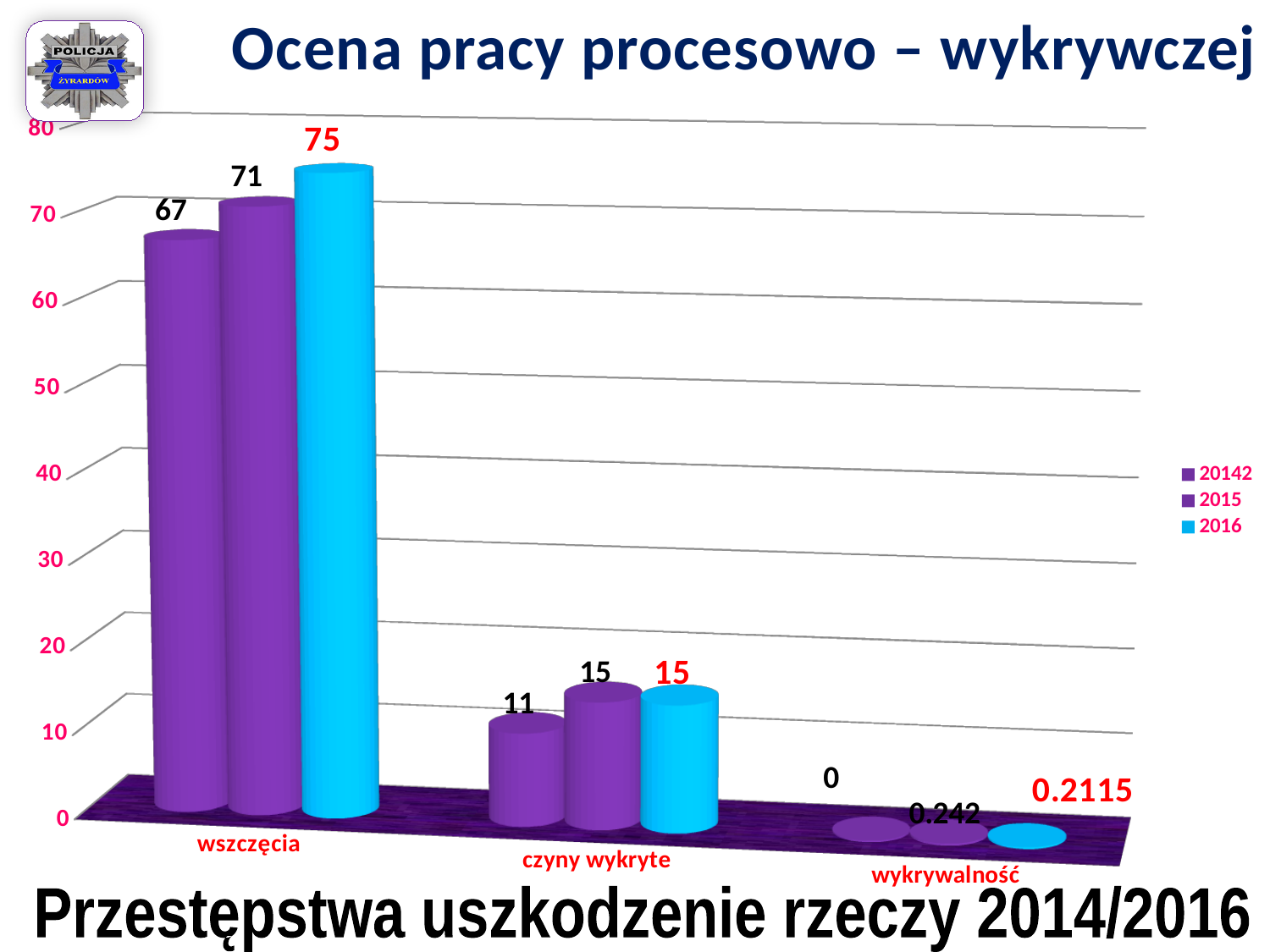
What is the value for czyny wykryte in the 2015 series? 15 What is the difference between the 2016 and 2015 values for wszczęcia? 4 Which category has the lowest value in the 2016 series? wykrywalność What is the value for wszczęcia in the series labelled 20142? 67 What is the value for wszczęcia in the 2016 series? 75 How many categories are shown on the x axis? 3 Which is larger for czyny wykryte: the value in the series labelled 20142 or the value in the 2015 series? 2015 What kind of chart is shown on the slide? bar chart Which category has the highest value in the 2015 series? wszczęcia How many series does the legend list? 3 What is the value for wykrywalność in the 2016 series? 0.2115